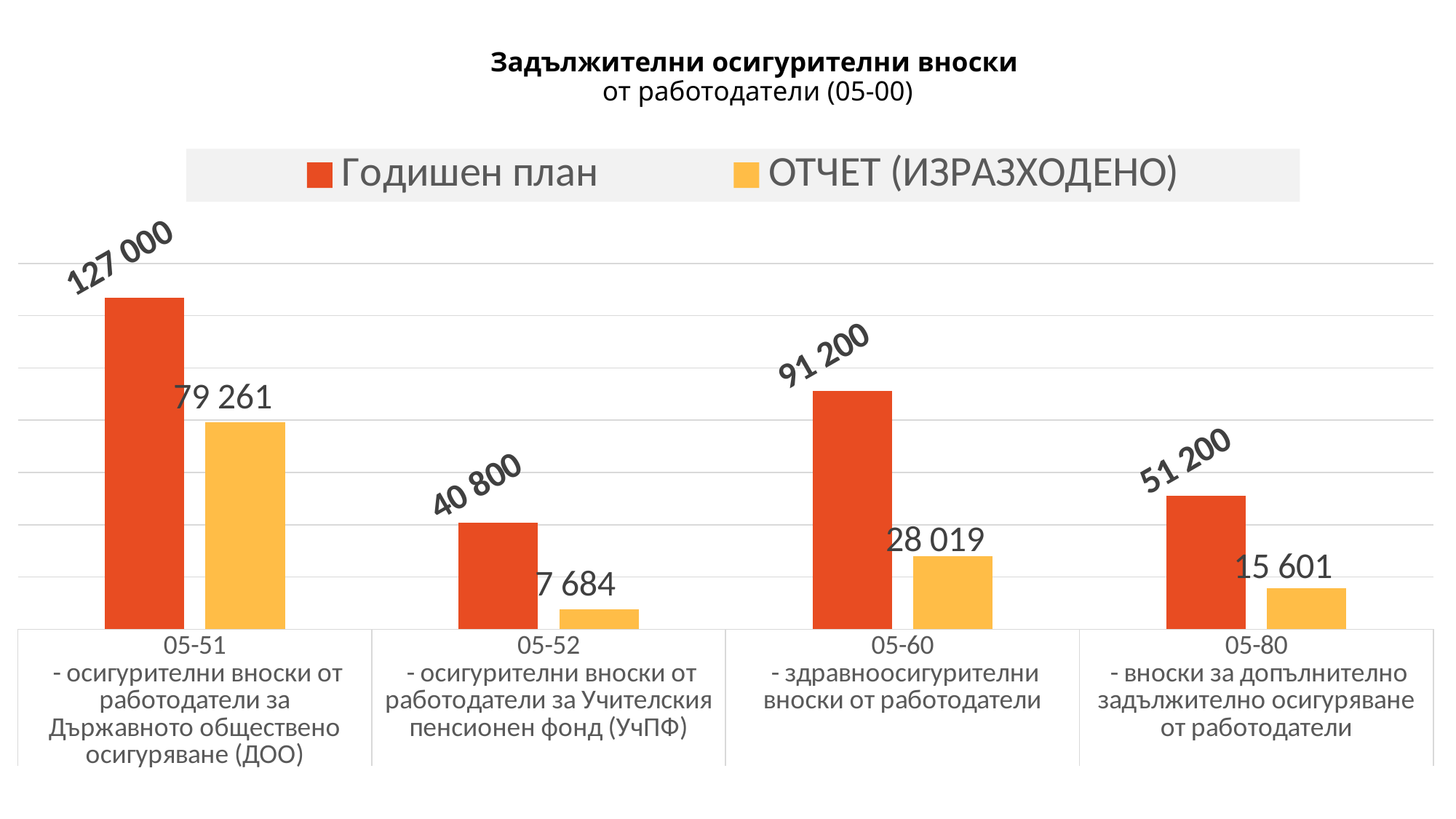
Which category has the highest Годишен план value? 05-51 What kind of chart is shown on the slide? Bar chart Which is larger: the Годишен план value for 05-60 or the Годишен план value for 05-80? 05-60 How many categories are shown on the x axis? 4 What is the ОТЧЕТ (ИЗРАЗХОДЕНО) value for category 05-60? 28 019 What is the Годишен план value for category 05-51? 127 000 What is the Годишен план value for category 05-80? 51 200 How many series does the legend list? 2 Which category has the lowest ОТЧЕТ (ИЗРАЗХОДЕНО) value? 05-52 What is the difference between the Годишен план and ОТЧЕТ (ИЗРАЗХОДЕНО) values for category 05-60? 63 181 What is the ОТЧЕТ (ИЗРАЗХОДЕНО) value for category 05-52? 7 684 What is the difference between the Годишен план and ОТЧЕТ (ИЗРАЗХОДЕНО) values for category 05-51? 47 739